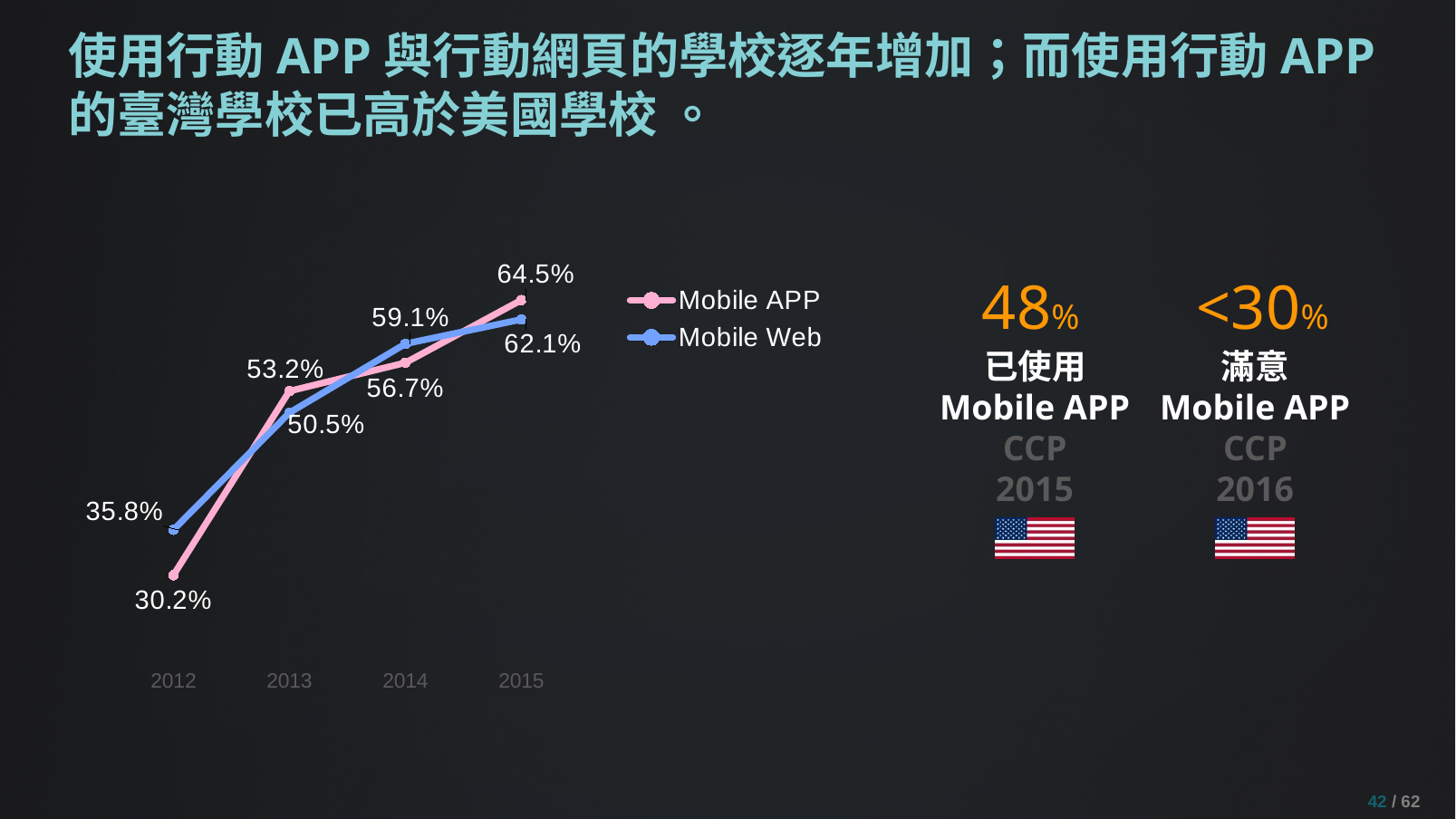
In which year is the Mobile APP value lowest? 2012 What is the Mobile Web value for 2012? 35.8% What is the Mobile APP value for 2013? 53.2% What type of chart is shown on the slide? line chart In which year is the Mobile Web value highest? 2015 Which series has the larger value in 2014, Mobile APP or Mobile Web? Mobile Web Does the Mobile APP series rise or fall from 2012 to 2015? rise What is the Mobile APP value for 2015? 64.5% How many series does the chart legend list? 2 What is the difference between the Mobile APP and Mobile Web values in 2012? 5.6% What is the Mobile Web value for 2014? 59.1% How many years are plotted on the x axis? 4